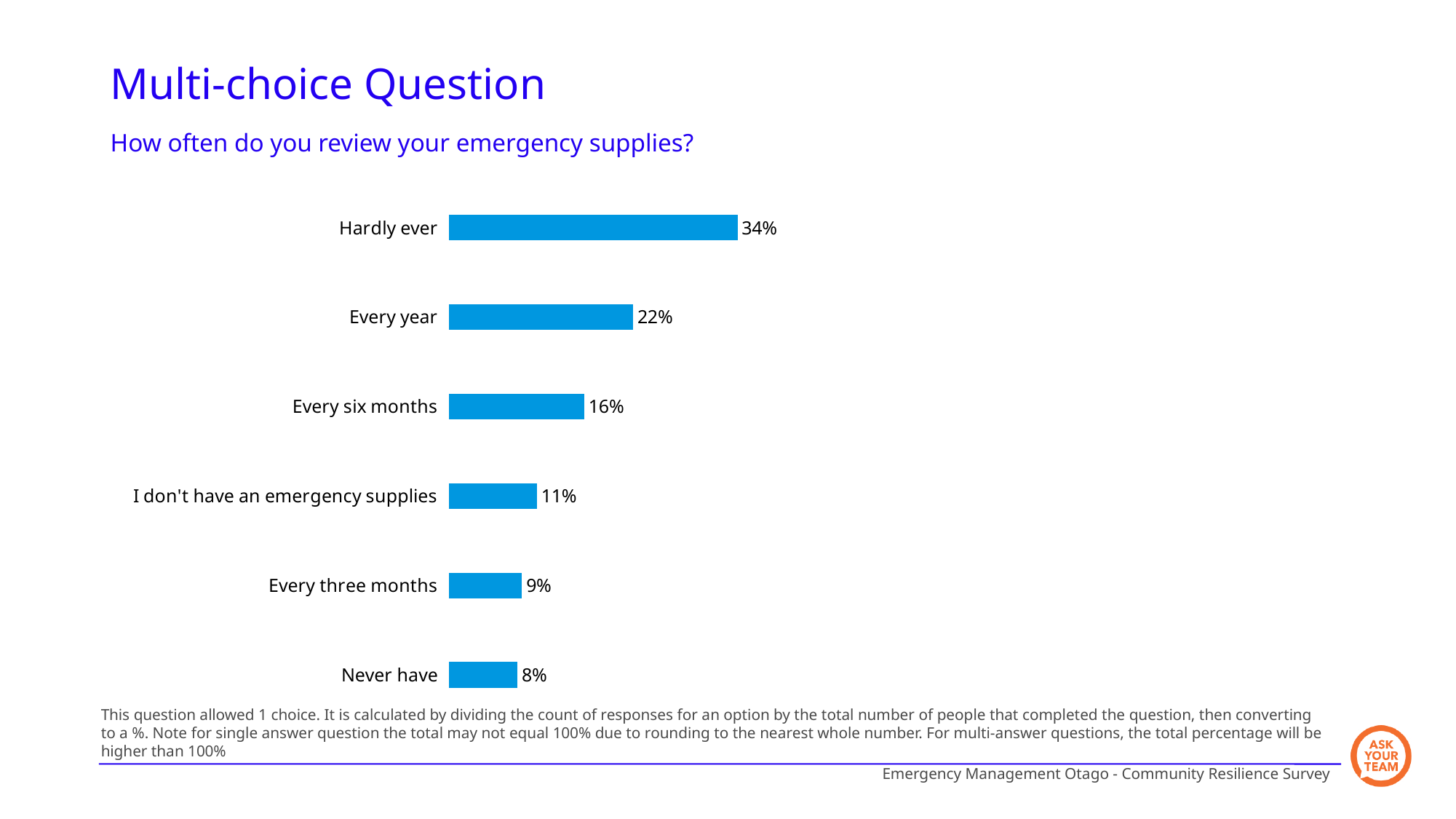
What is the difference between the values for 'Hardly ever' and 'Every year'? 12% What is the difference between 'Every three months' and 'Never have'? 1% Which is larger, the value for 'Every year' or the value for 'Every six months'? Every year How many categories are shown in the chart? 6 What question does the chart present results for? How often do you review your emergency supplies? What percentage of respondents said they review their emergency supplies 'Hardly ever'? 34% What is the value shown for 'Every six months'? 16% Which category has the highest value? Hardly ever What percentage of respondents said 'I don't have an emergency supplies'? 11% What kind of chart is shown on the slide? Bar chart Which category has the lowest value? Never have What is the value for 'Never have'? 8%